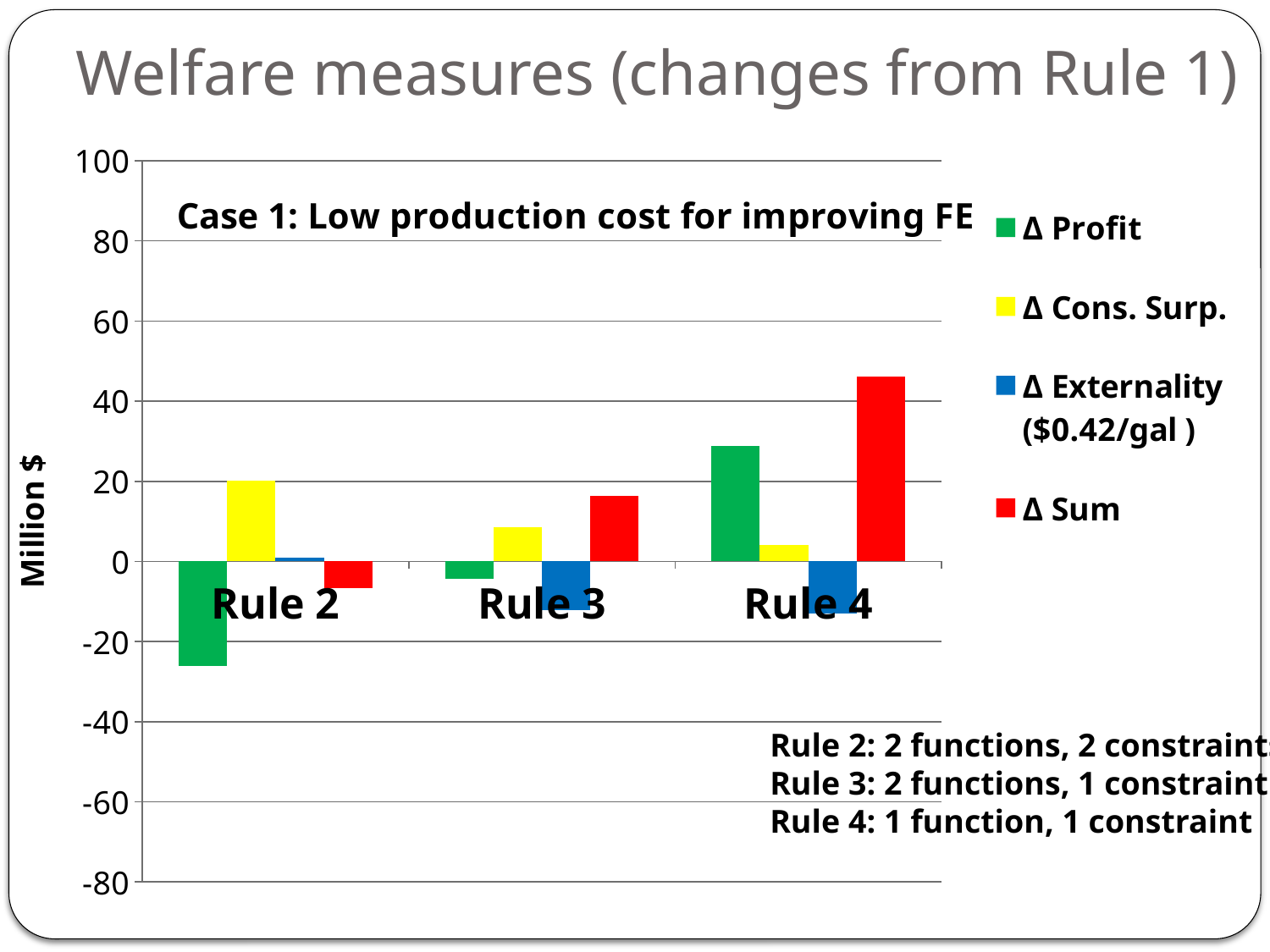
What kind of chart is shown on the slide? bar chart How many series does the legend list? 4 Does Δ Sum rise or fall from Rule 2 to Rule 4? rises Which rule has the highest Δ Sum? Rule 4 How many rule categories are shown on the x axis? 3 Is the Δ Sum value for Rule 4 greater or less than 40? greater Is the Δ Profit value for Rule 2 greater or less than -20? less What case is described in the text inside the chart area? Case 1: Low production cost for improving FE Is the Δ Profit value for Rule 4 greater or less than 20? greater Which is larger, Δ Cons. Surp. for Rule 2 or Δ Cons. Surp. for Rule 3? Rule 2 What is the label on the vertical axis? Million $ Which rule has the lowest Δ Profit? Rule 2